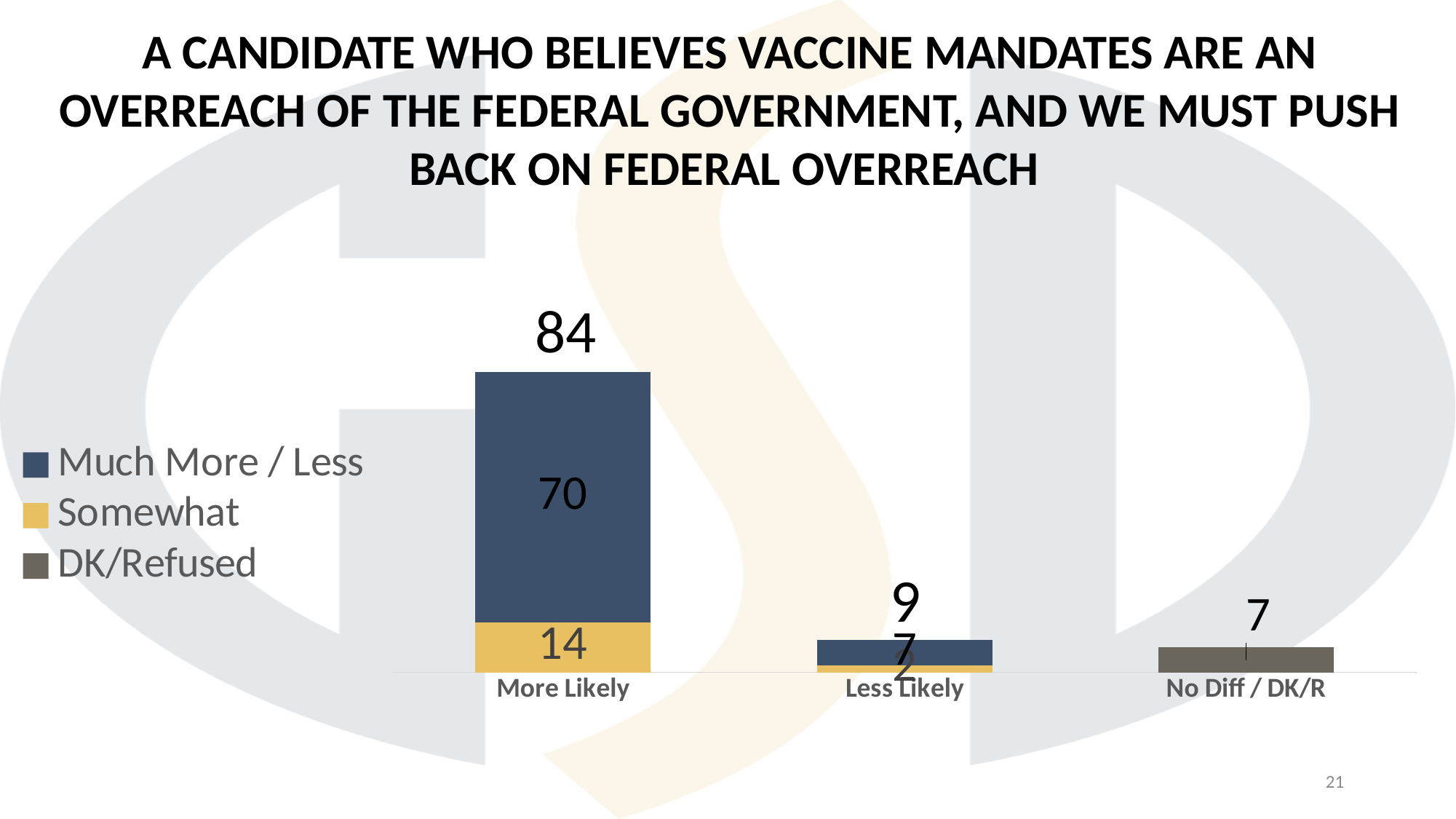
What is the total value shown above the Less Likely bar? 9 What kind of chart is shown on the slide? Stacked bar chart What is the Somewhat value for the More Likely category? 14 Which legend entry is shown in gold/yellow? Somewhat Which is larger: the Much More / Less value for More Likely or the Somewhat value for More Likely? Much More / Less How many series does the legend list? 3 What is the Much More / Less value for the More Likely category? 70 What is the value for the No Diff / DK/R category? 7 How many categories are shown on the x axis? 3 Which category has the highest total? More Likely What is the total value shown above the More Likely bar? 84 What is the difference between the More Likely total and the Less Likely total? 75